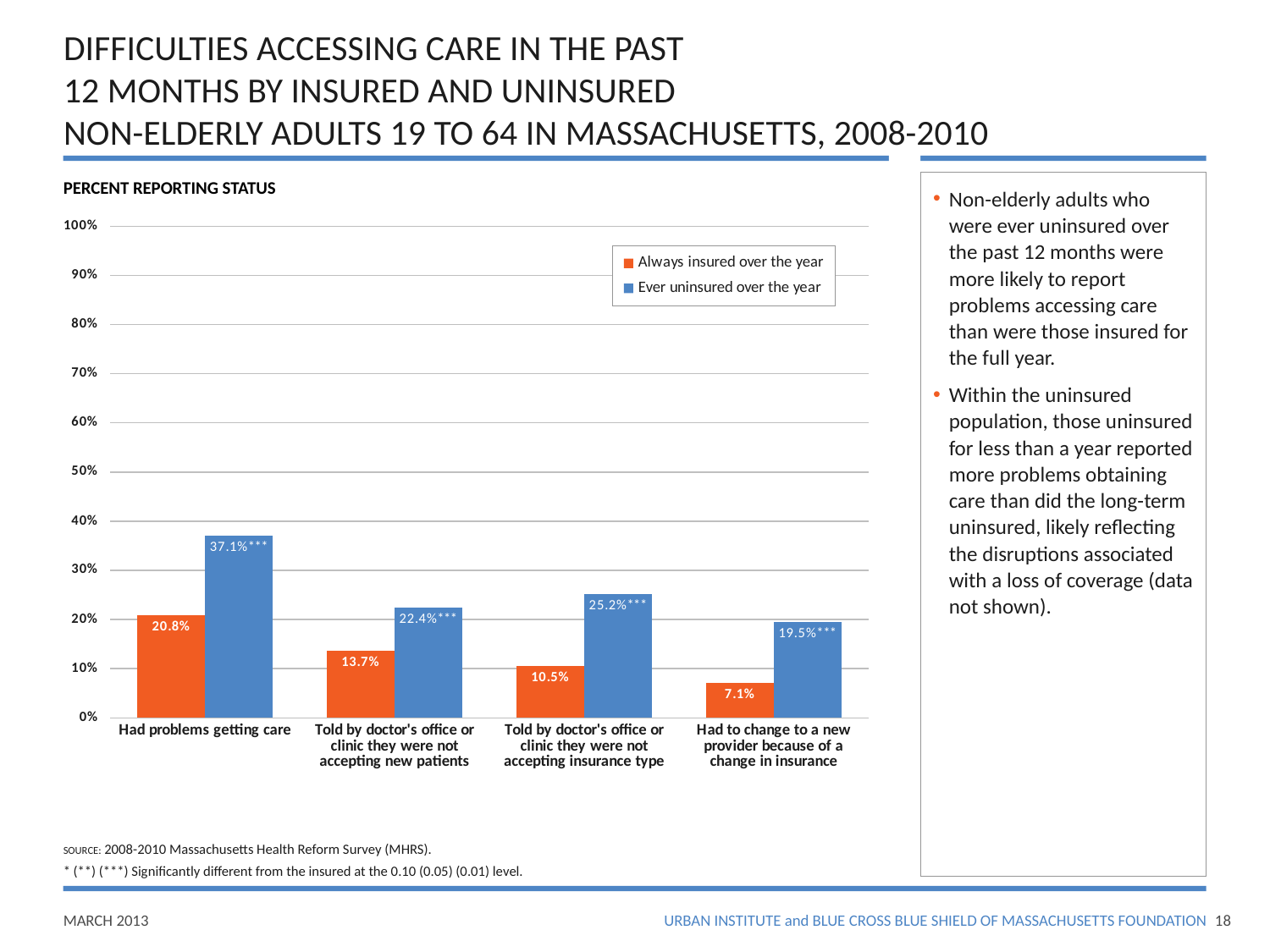
Which category has the highest value for 'Ever uninsured over the year'? Had problems getting care What is the value for 'Always insured over the year' in the 'Had problems getting care' category? 20.8% How many categories are shown on the x axis? 4 What is the value for 'Ever uninsured over the year' in the 'Had problems getting care' category? 37.1% What colour represents 'Always insured over the year' in the chart? Orange What is the value for 'Ever uninsured over the year' in the 'Had to change to a new provider because of a change in insurance' category? 19.5% What is the difference between the 'Ever uninsured over the year' and 'Always insured over the year' values in the 'Told by doctor's office or clinic they were not accepting new patients' category? 8.7% How many series does the legend list? 2 Which category has the lowest value for 'Always insured over the year'? Had to change to a new provider because of a change in insurance Which is larger in the 'Told by doctor's office or clinic they were not accepting insurance type' category: 'Always insured over the year' or 'Ever uninsured over the year'? Ever uninsured over the year What kind of chart is shown on the slide? Bar chart What is the value for 'Always insured over the year' in the 'Told by doctor's office or clinic they were not accepting insurance type' category? 10.5%